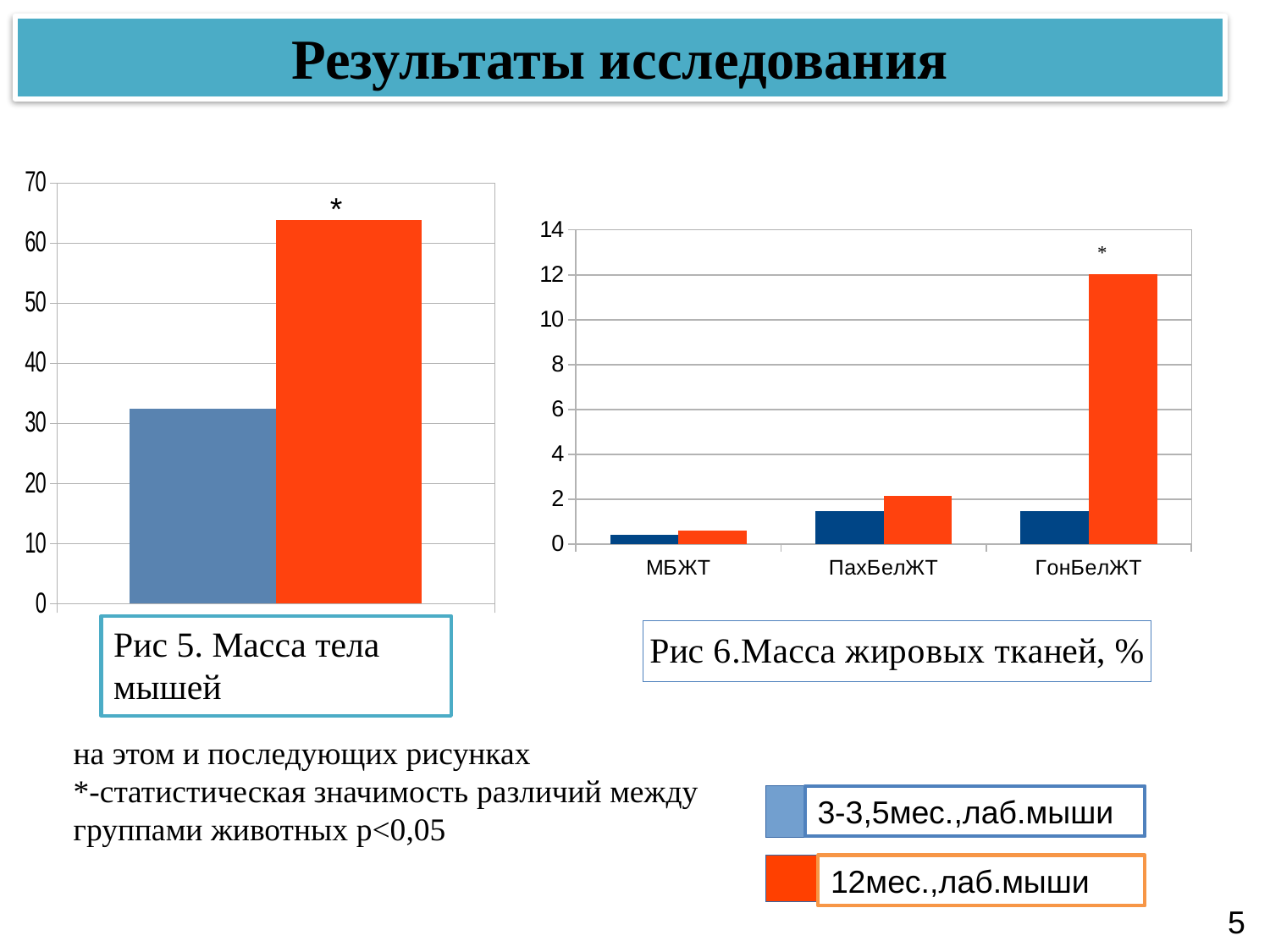
What kind of chart is Рис 5. Масса тела мышей? bar chart In Рис 6.Масса жировых тканей, %, is the value for ГонБелЖТ in the 12мес.,лаб.мыши series greater or less than 10? greater In Рис 6.Масса жировых тканей, %, which category has the lowest value for 12мес.,лаб.мыши? МБЖТ In Рис 5. Масса тела мышей, is the value for the 3-3,5мес.,лаб.мыши bar greater or less than 40? less In Рис 6.Масса жировых тканей, %, which is larger for ГонБелЖТ: the 3-3,5мес.,лаб.мыши value or the 12мес.,лаб.мыши value? 12мес.,лаб.мыши In Рис 6.Масса жировых тканей, %, how many categories are shown on the x axis? 3 In Рис 5. Масса тела мышей, which group has the larger body mass, 3-3,5мес.,лаб.мыши or 12мес.,лаб.мыши? 12мес.,лаб.мыши What kind of chart is Рис 6.Масса жировых тканей, %? bar chart Which colour represents the 12мес.,лаб.мыши group in the charts? orange In Рис 5. Масса тела мышей, is the value for the 12мес.,лаб.мыши bar greater or less than 60? greater In Рис 6.Масса жировых тканей, %, which category has the highest value for 12мес.,лаб.мыши? ГонБелЖТ